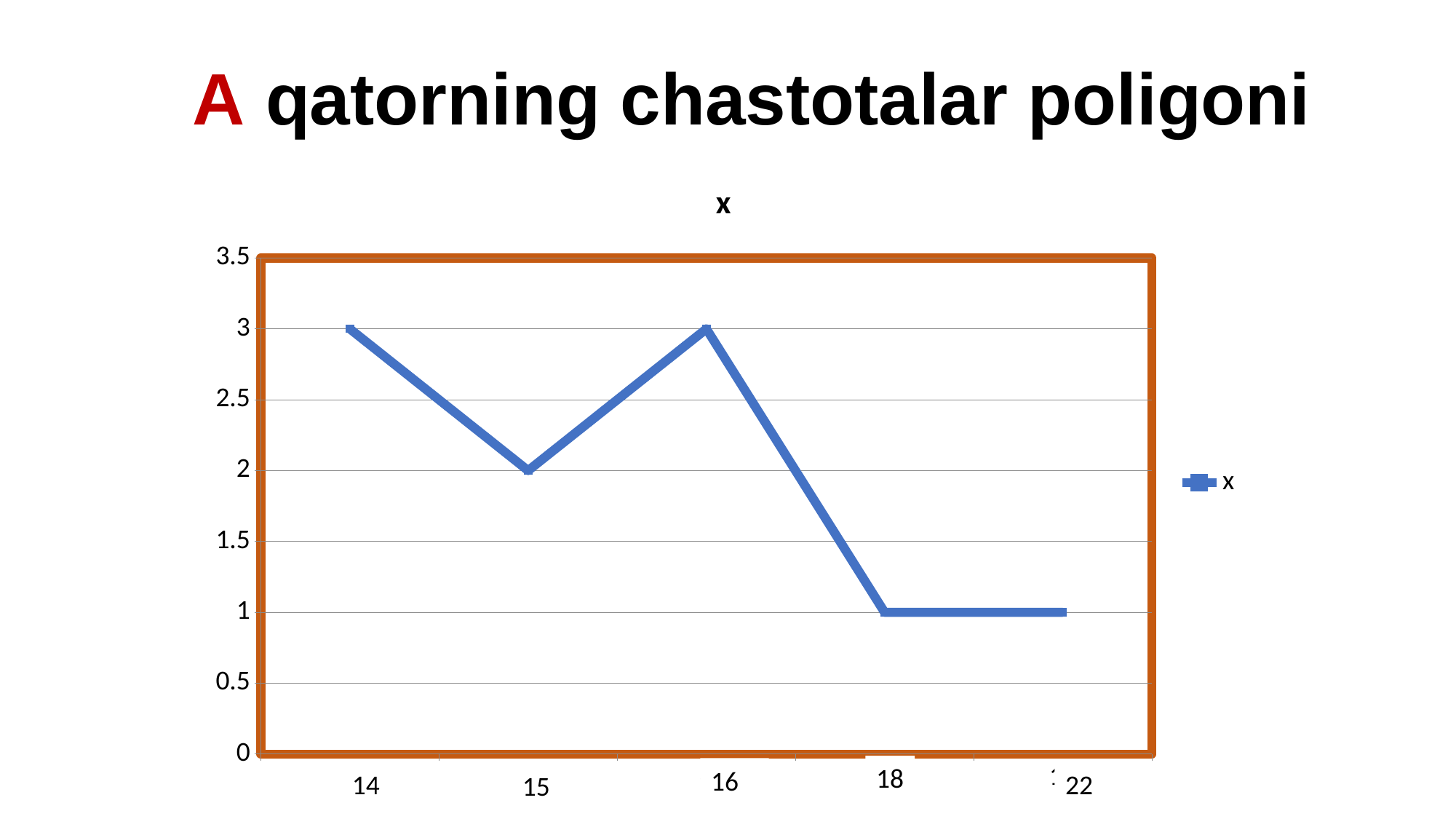
What is the title of the chart? x Which category has the lowest value, 15 or 18? 18 What is the value for 22? 1 How many points are plotted on the line? 5 Does the value rise or fall from 16 to 18? fall Is the value for 16 greater or less than 2.5? greater What kind of chart is shown on the slide? line chart How many series does the legend list? 1 What is the value for 14? 3 What is the difference between the values for 14 and 15? 1 What is the value for 18? 1 What is the value for 15? 2